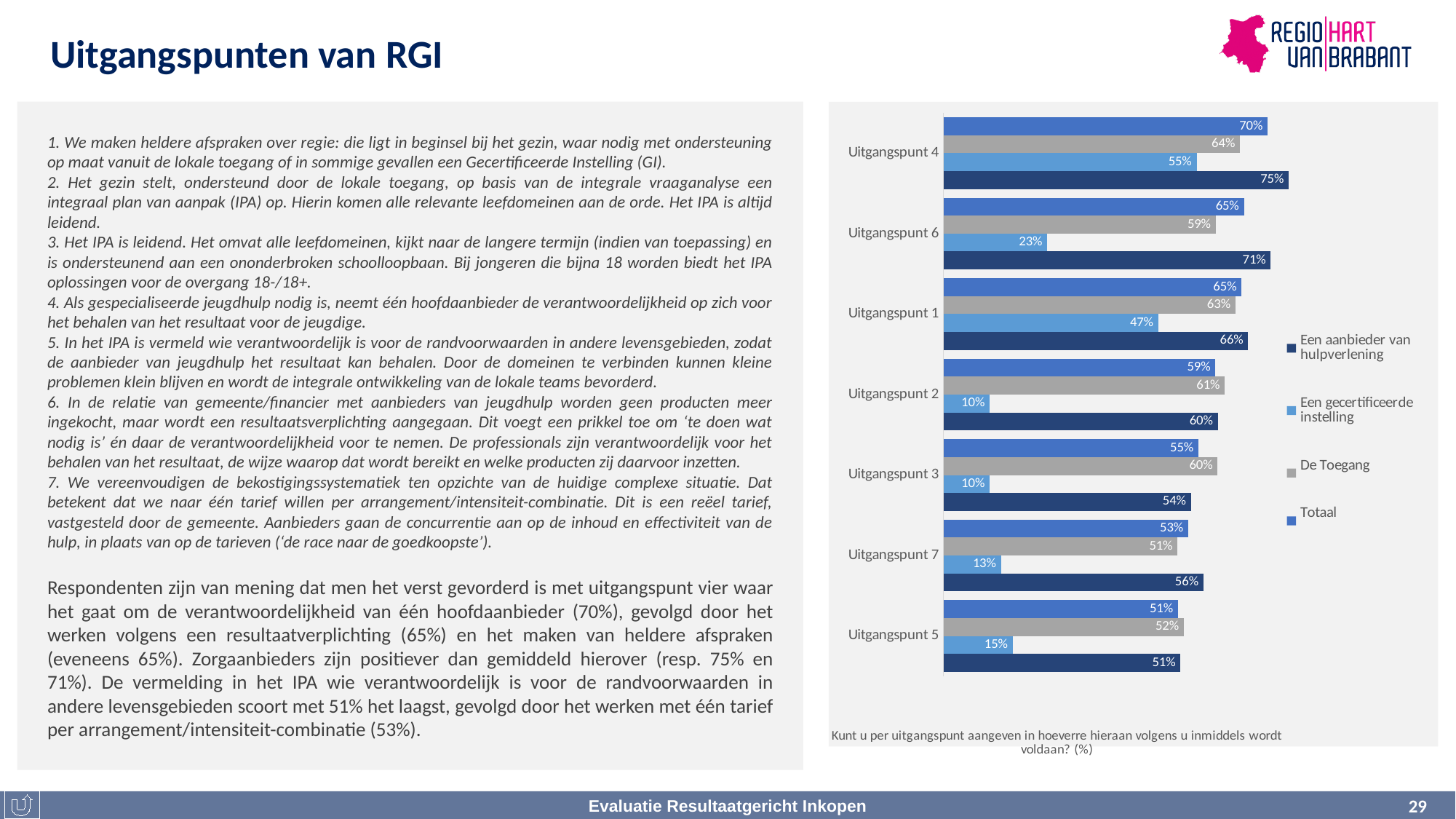
What is the difference between the Een aanbieder van hulpverlening value and the Een gecertificeerde instelling value for Uitgangspunt 6? 48% How many series does the chart legend list? 4 Which series is shown in gray in the chart? De Toegang What is the value for Een gecertificeerde instelling for Uitgangspunt 2? 10% For Uitgangspunt 3, which is larger: the De Toegang value or the Totaal value? De Toegang How many Uitgangspunt categories are shown in the chart? 7 What is the Totaal value for Uitgangspunt 4? 70% Which Uitgangspunt has the highest Totaal value? Uitgangspunt 4 What is the De Toegang value for Uitgangspunt 1? 63% What is the value for Een aanbieder van hulpverlening for Uitgangspunt 6? 71% What type of chart is shown on the slide? bar chart Which Uitgangspunt has the lowest Totaal value? Uitgangspunt 5